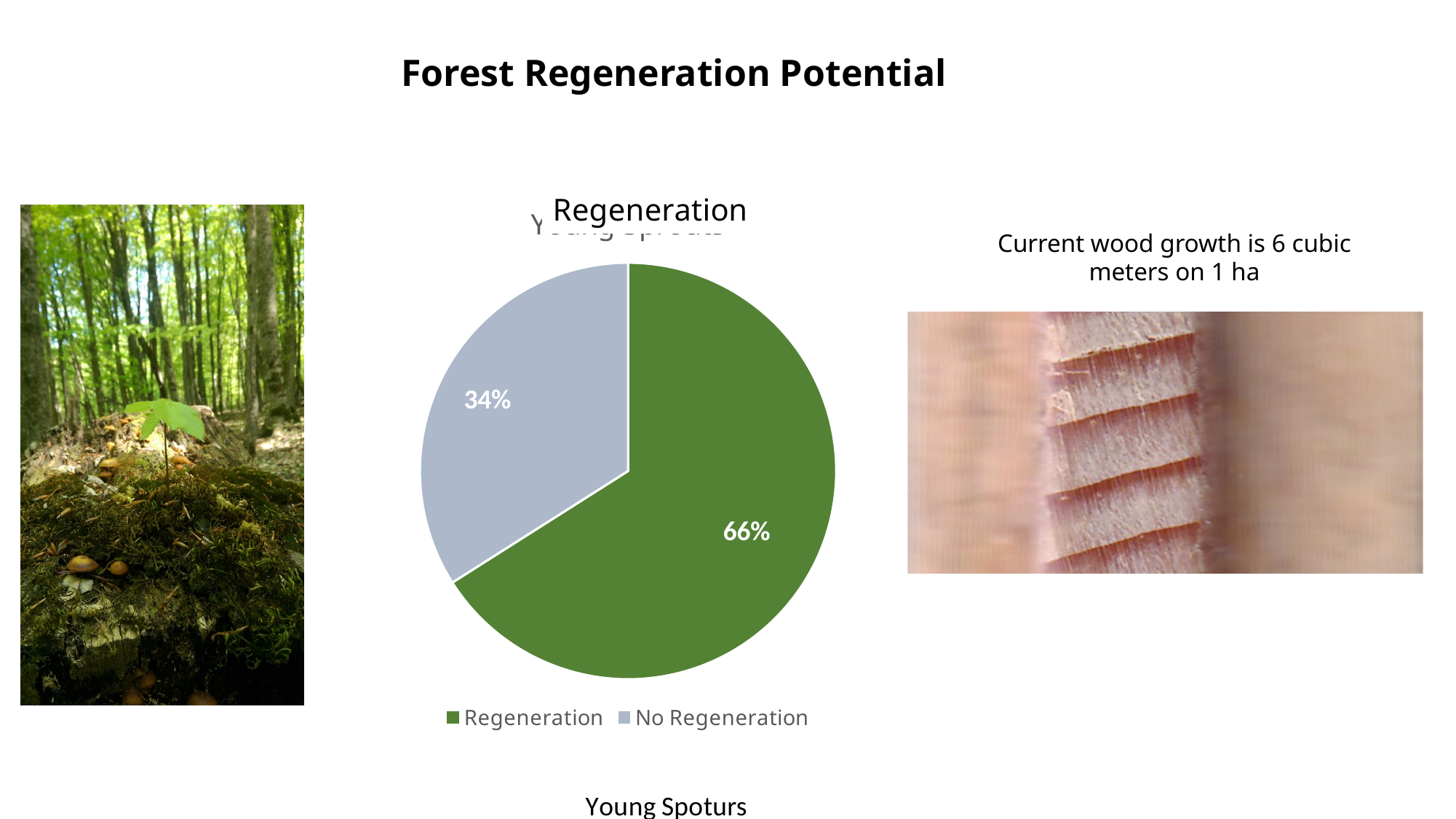
How many slices does the pie chart have? 2 What colour is the No Regeneration slice in the pie chart? grey-blue What colour is the Regeneration slice in the pie chart? green Which is larger in the pie chart, Regeneration or No Regeneration? Regeneration What percentage of the pie chart is labelled Regeneration? 66% Which slice of the pie chart is the smallest? No Regeneration How many entries does the pie chart legend list? 2 Which slice of the pie chart is the largest? Regeneration What is the difference in percentage points between the Regeneration and No Regeneration slices? 32 What type of chart is shown on the slide? pie chart What percentage of the pie chart is labelled No Regeneration? 34%